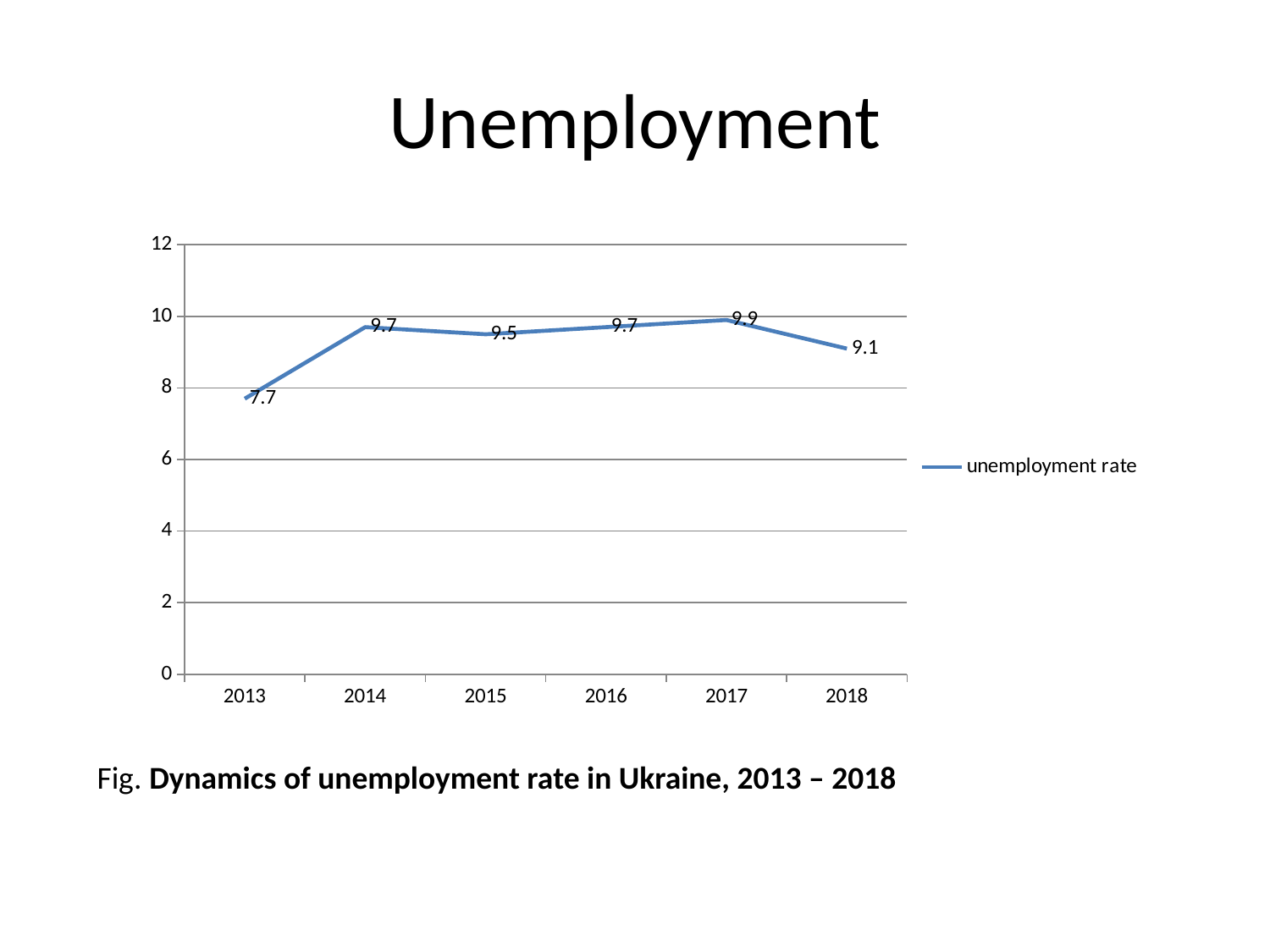
Which year has the lowest unemployment rate? 2013 What is the difference between the unemployment rate in 2014 and in 2013? 2 What is the unemployment rate for 2013? 7.7 Which year has a higher unemployment rate, 2015 or 2016? 2016 Is the unemployment rate for 2013 greater or less than 8? less Which year has the highest unemployment rate? 2017 What is the difference between the unemployment rate in 2017 and in 2018? 0.8 What is the name of the series shown in the legend? unemployment rate What is the unemployment rate for 2018? 9.1 What kind of chart is shown on the slide? line chart How many years are plotted on the chart? 6 What is the unemployment rate for 2017? 9.9